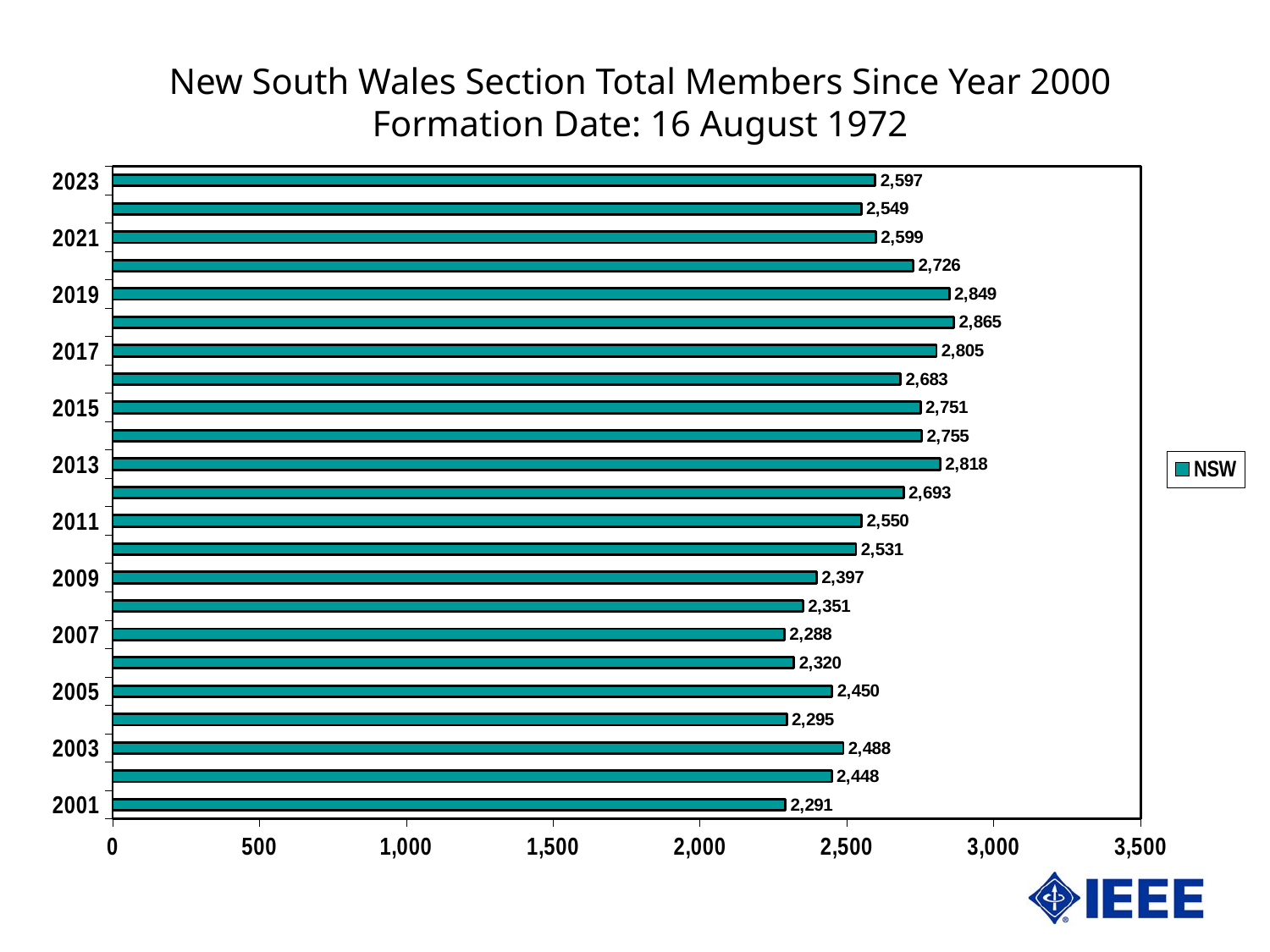
Which year has more members, 2019 or 2021? 2019 What is the total number of NSW members in 2001? 2,291 How many series does the legend list? 1 What is the total number of NSW members in 2023? 2,597 How many bars are plotted on the chart? 23 What is the difference between the values for 2023 and 2001? 306 What is the name of the series shown in the legend? NSW What is the value shown for 2017? 2,805 What is the highest value shown on the chart? 2,865 What is the value shown for 2013? 2,818 Which year has the lowest number of members? 2007 What type of chart is shown on the slide? bar chart